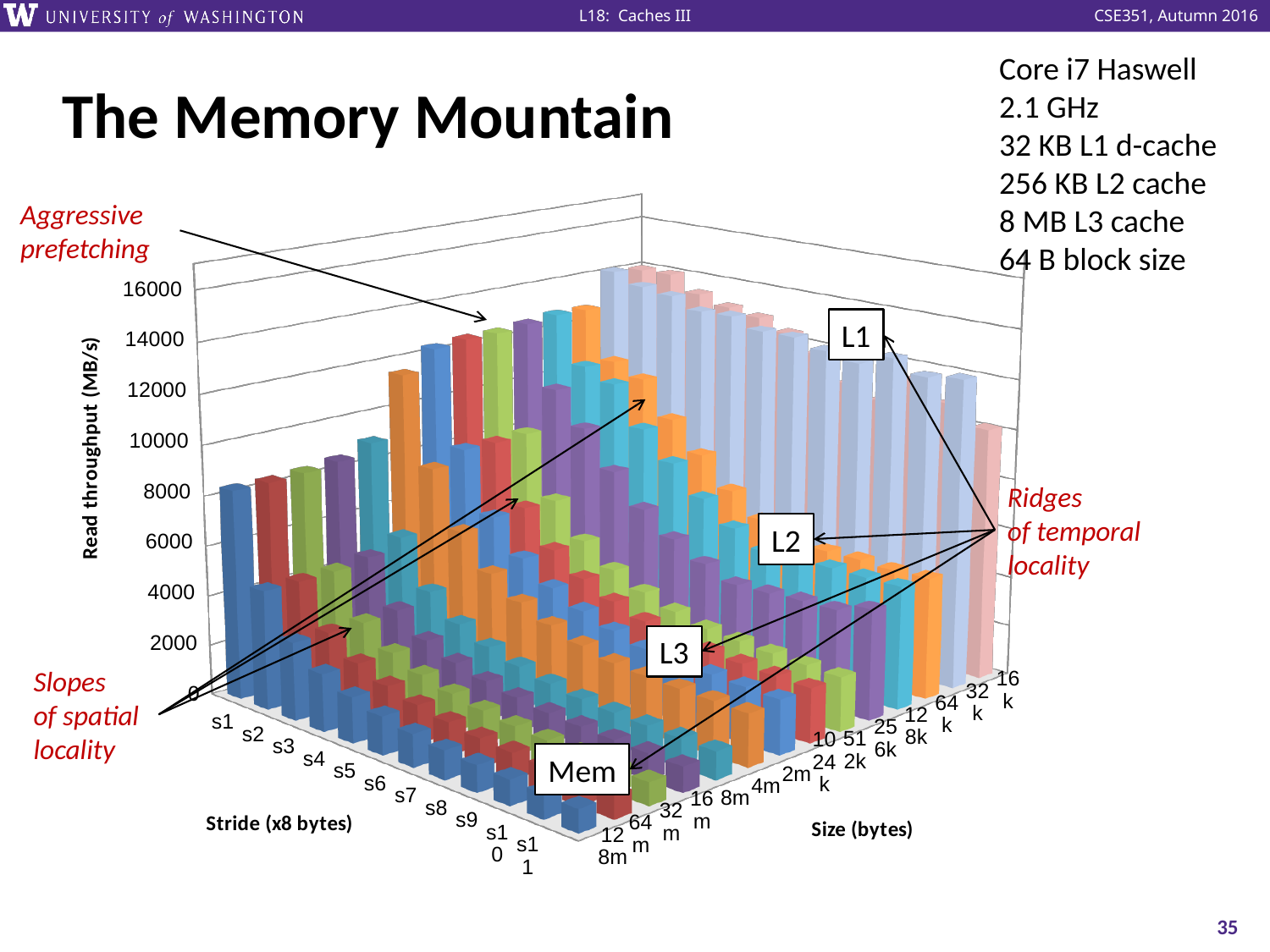
What is the title of the chart on the slide? The Memory Mountain Is the read throughput for stride s11 at size 128m greater or less than 2000? less For stride s1, does read throughput rise or fall as the size decreases from 128m toward 16k? rise How many stride categories (s1 through s11) are shown along the Stride axis? 11 What kind of chart is shown on the slide? 3D bar chart Which is larger: the read throughput for stride s1 at size 128m or for stride s11 at size 128m? s1 at 128m Is the read throughput for stride s1 at size 16k greater or less than 10000? greater What is the maximum value shown on the Read throughput axis? 16000 For a fixed size, does read throughput rise or fall as the stride increases from s1 to s11? fall What is the label of the vertical axis of the chart? Read throughput (MB/s) How many size categories are shown along the Size (bytes) axis? 14